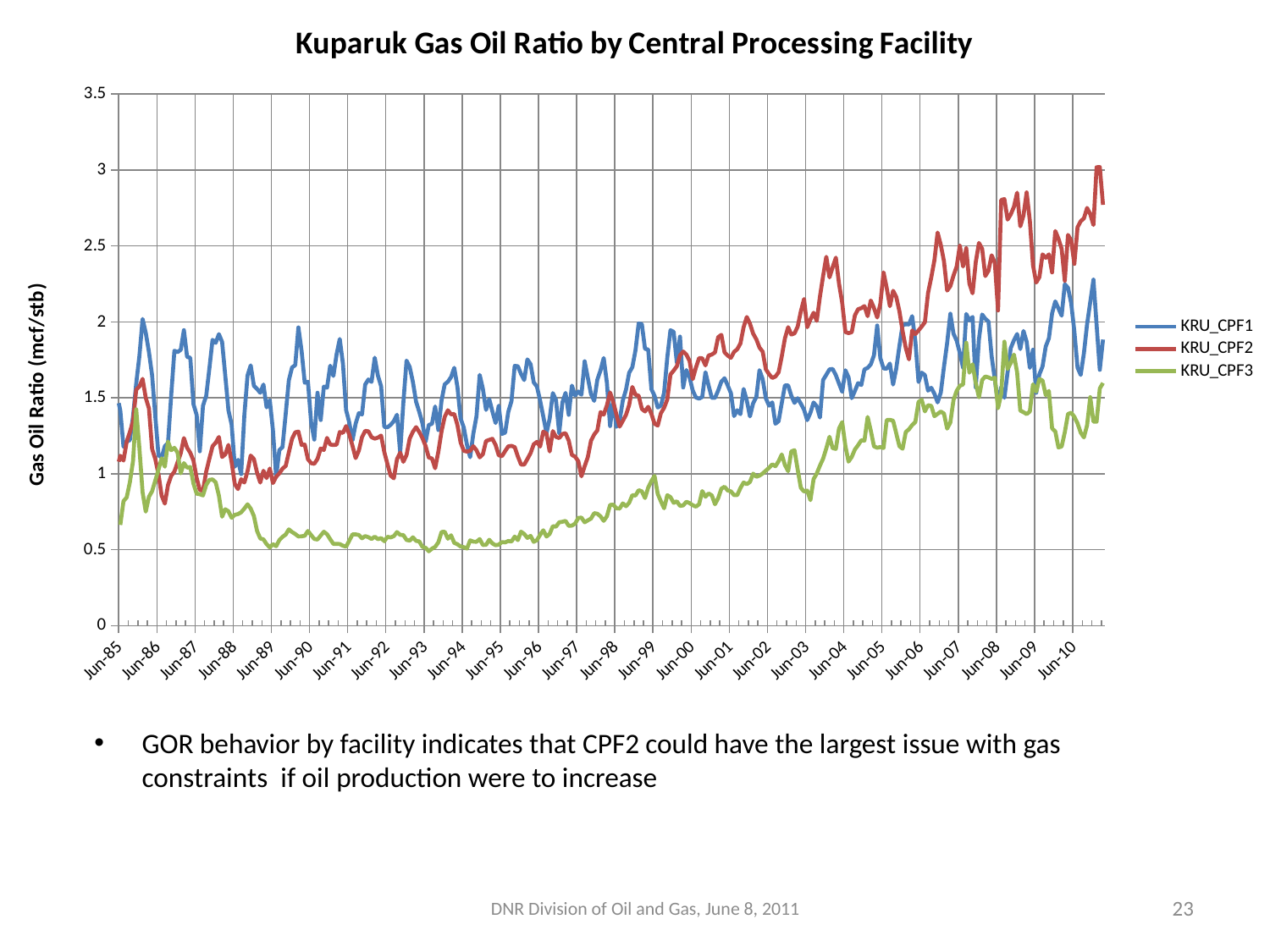
Is the value for KRU_CPF1 at Jun-85 greater or less than 2? less At Jun-10, which series has the larger value, KRU_CPF2 or KRU_CPF3? KRU_CPF2 How many series does the legend list? 3 What is the label on the vertical axis? Gas Oil Ratio (mcf/stb) At Jun-90, which series has the larger value, KRU_CPF1 or KRU_CPF3? KRU_CPF1 Does the KRU_CPF2 series generally rise or fall from Jun-85 to Jun-10? Rise Is the value for KRU_CPF3 at Jun-93 greater or less than 1? less Which series reaches the highest value on the chart? KRU_CPF2 What kind of chart is shown on the slide? Line chart Which series has the lowest values around Jun-93? KRU_CPF3 What is the title of the chart? Kuparuk Gas Oil Ratio by Central Processing Facility